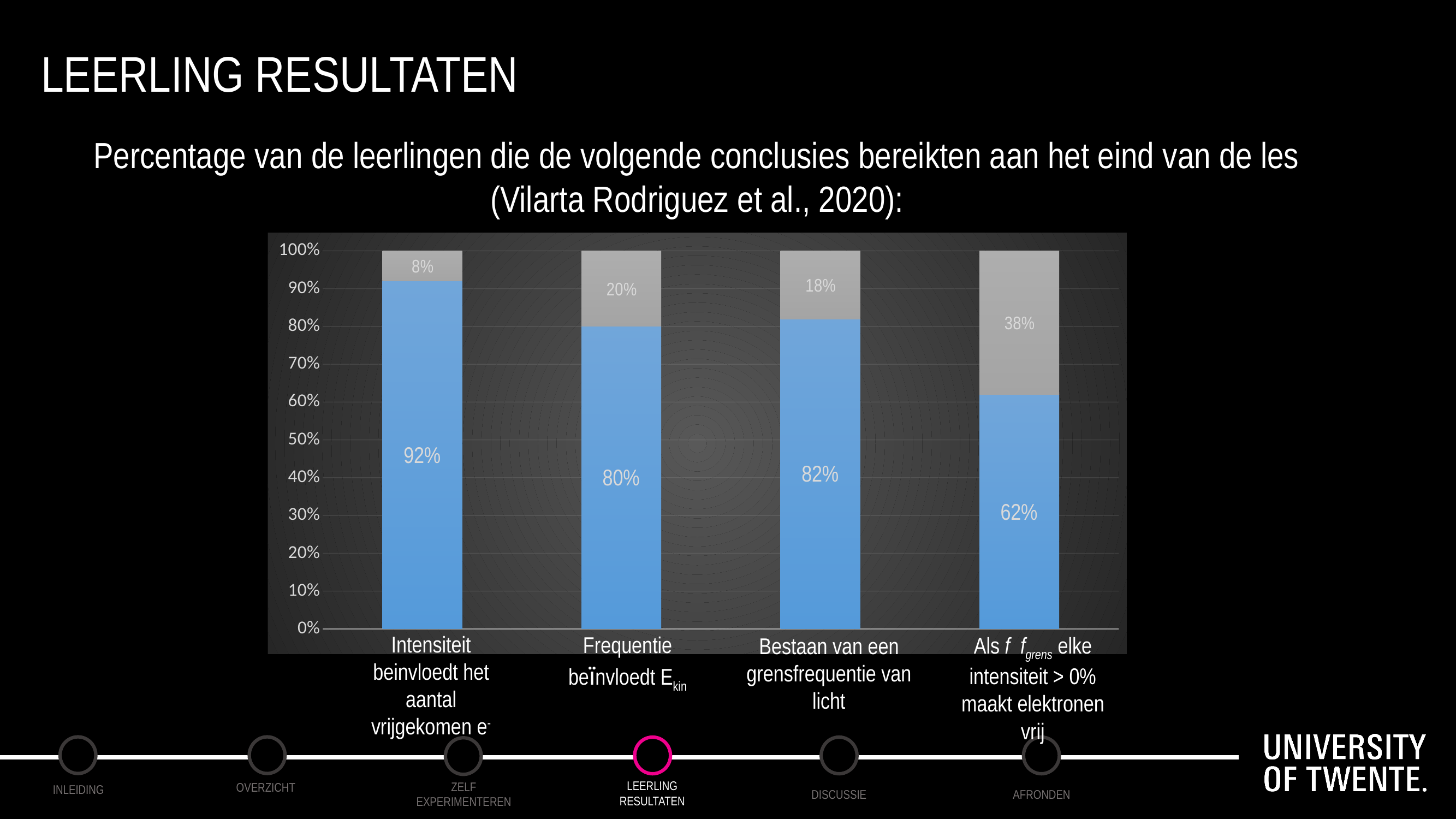
What is the total of the stacked bar for "Frequentie beïnvloedt Ekin"? 100% Which category has the highest blue segment value? Intensiteit beinvloedt het aantal vrijgekomen e- Which has a larger blue segment value: "Bestaan van een grensfrequentie van licht" or "Frequentie beïnvloedt Ekin"? Bestaan van een grensfrequentie van licht Which category has the lowest blue segment value? Als f fgrens elke intensiteit > 0% maakt elektronen vrij What kind of chart is shown on the slide? Stacked bar chart What is the difference between the blue segment values for "Intensiteit beinvloedt het aantal vrijgekomen e-" and "Frequentie beïnvloedt Ekin"? 12 percentage points What is the difference between the grey segment values for "Als f fgrens elke intensiteit > 0% maakt elektronen vrij" and "Intensiteit beinvloedt het aantal vrijgekomen e-"? 30 percentage points What is the value of the grey segment for the category "Als f fgrens elke intensiteit > 0% maakt elektronen vrij"? 38% How many categories are shown on the x axis of the chart? 4 What is the value of the blue segment for the category "Intensiteit beinvloedt het aantal vrijgekomen e-"? 92% What is the value of the blue segment for the category "Frequentie beïnvloedt Ekin"? 80% What is the value of the grey segment for the category "Bestaan van een grensfrequentie van licht"? 18%